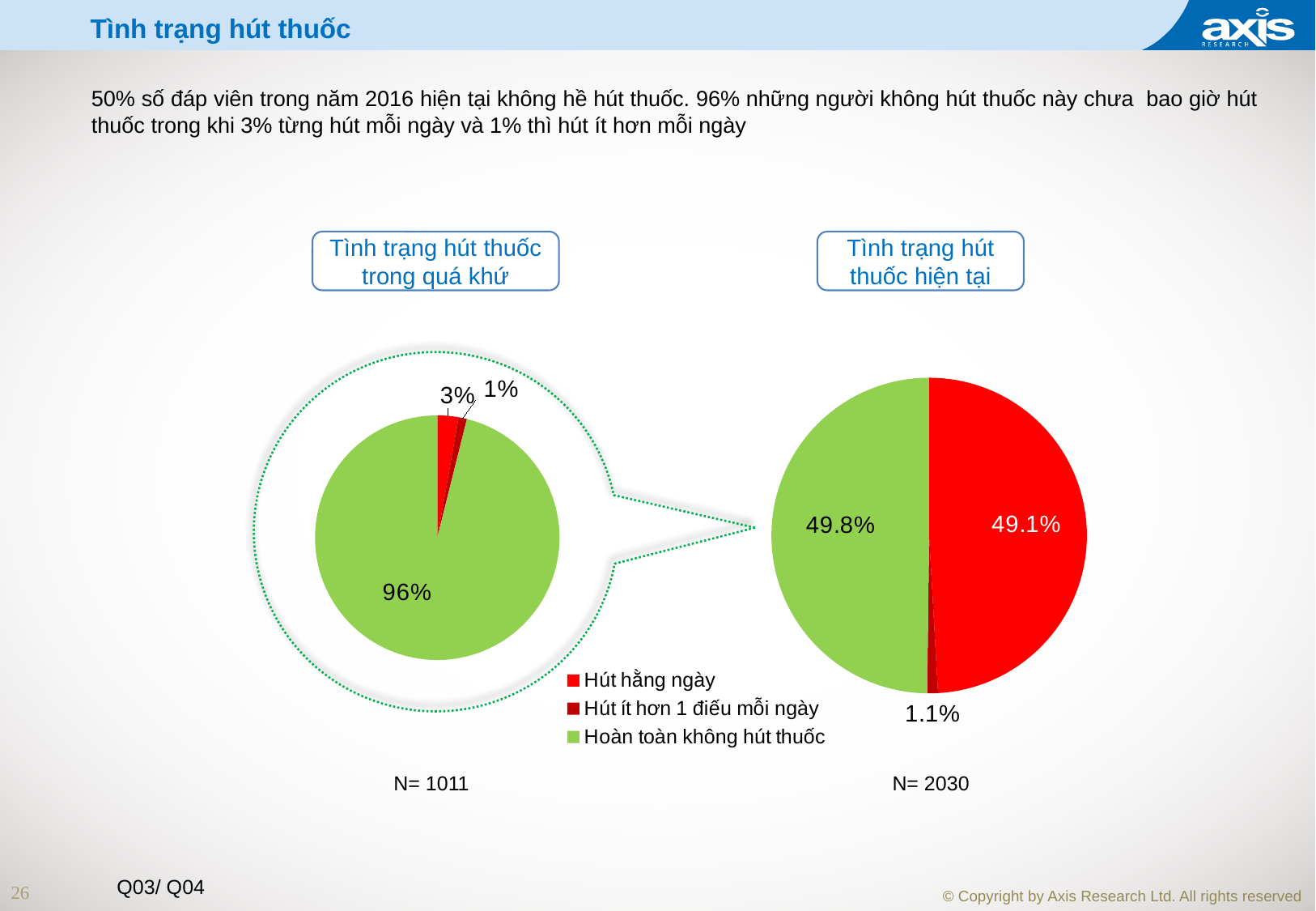
In the 'Tình trạng hút thuốc hiện tại' chart, what is the difference between the 'Hoàn toàn không hút thuốc' share and the 'Hút hằng ngày' share? 0.7% In the 'Tình trạng hút thuốc trong quá khứ' chart, what share is shown for 'Hút ít hơn 1 điếu mỗi ngày'? 1% In the 'Tình trạng hút thuốc trong quá khứ' chart, what share is shown for 'Hút hằng ngày'? 3% In the 'Tình trạng hút thuốc hiện tại' chart, which category has the smallest slice? Hút ít hơn 1 điếu mỗi ngày In the 'Tình trạng hút thuốc trong quá khứ' chart, what share is shown for 'Hoàn toàn không hút thuốc'? 96% How many categories does the legend list for the pie charts? 3 In the 'Tình trạng hút thuốc hiện tại' chart, what share is shown for 'Hút hằng ngày'? 49.1% In the 'Tình trạng hút thuốc trong quá khứ' chart, what is the difference between the 'Hút hằng ngày' share and the 'Hút ít hơn 1 điếu mỗi ngày' share? 2% In the 'Tình trạng hút thuốc hiện tại' chart, what share is shown for 'Hút ít hơn 1 điếu mỗi ngày'? 1.1% In the 'Tình trạng hút thuốc hiện tại' chart, what share is shown for 'Hoàn toàn không hút thuốc'? 49.8% What type of chart is used for 'Tình trạng hút thuốc hiện tại'? Pie chart In the 'Tình trạng hút thuốc trong quá khứ' chart, which category has the largest slice? Hoàn toàn không hút thuốc